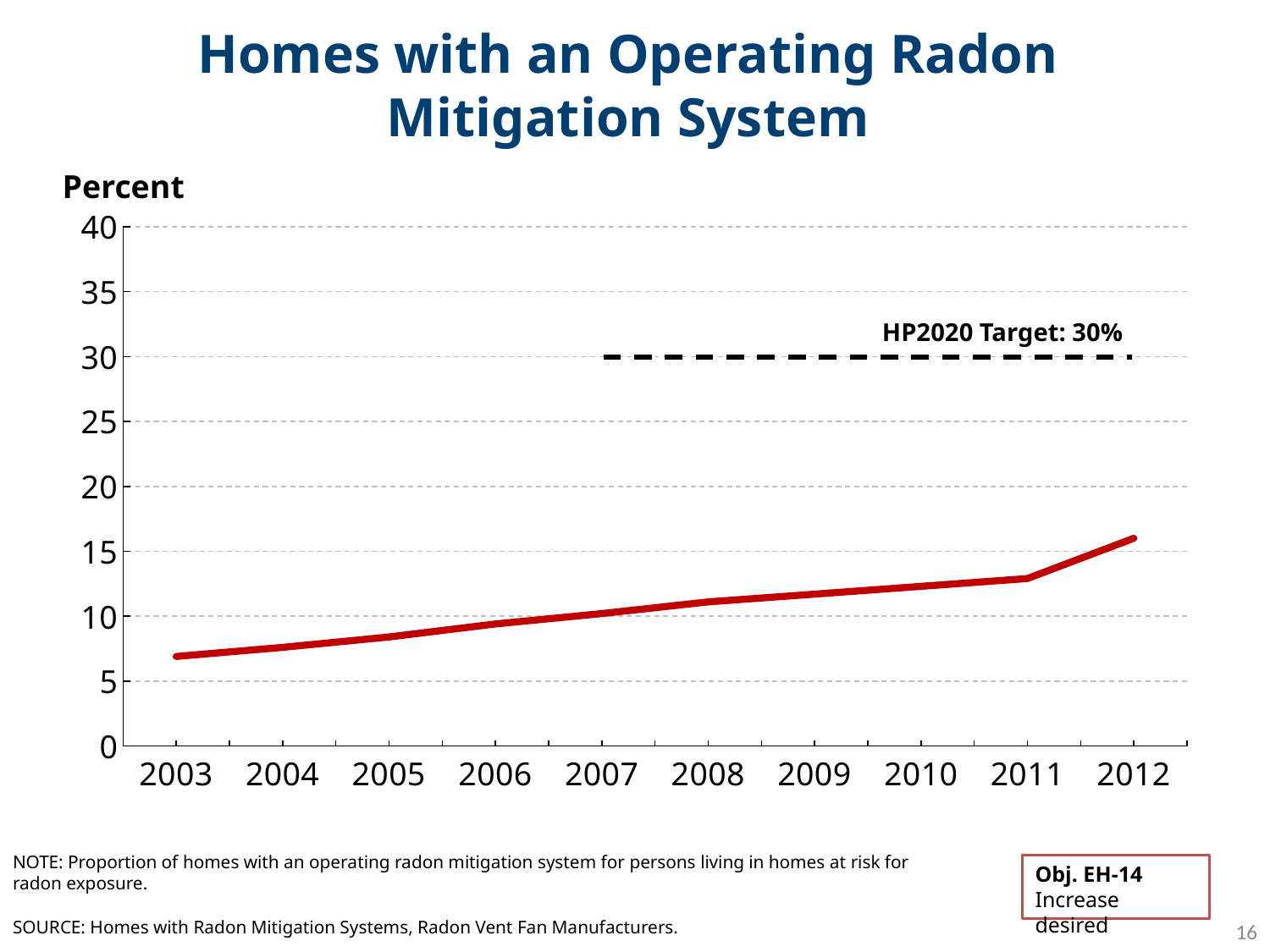
What kind of chart is shown on the slide? line chart Is the value for 2012 greater or less than 15? greater Which is larger, the value for 2012 or the value for 2003? 2012 Is the value for 2011 greater or less than 15? less What is the label on the vertical axis? Percent Do the values rise or fall from 2003 to 2012? rise Is the value for 2009 greater or less than 10? greater What is the HP2020 Target value shown on the chart? 30% Which year has the highest value? 2012 How many years are plotted along the x axis? 10 Which year has the lowest value? 2003